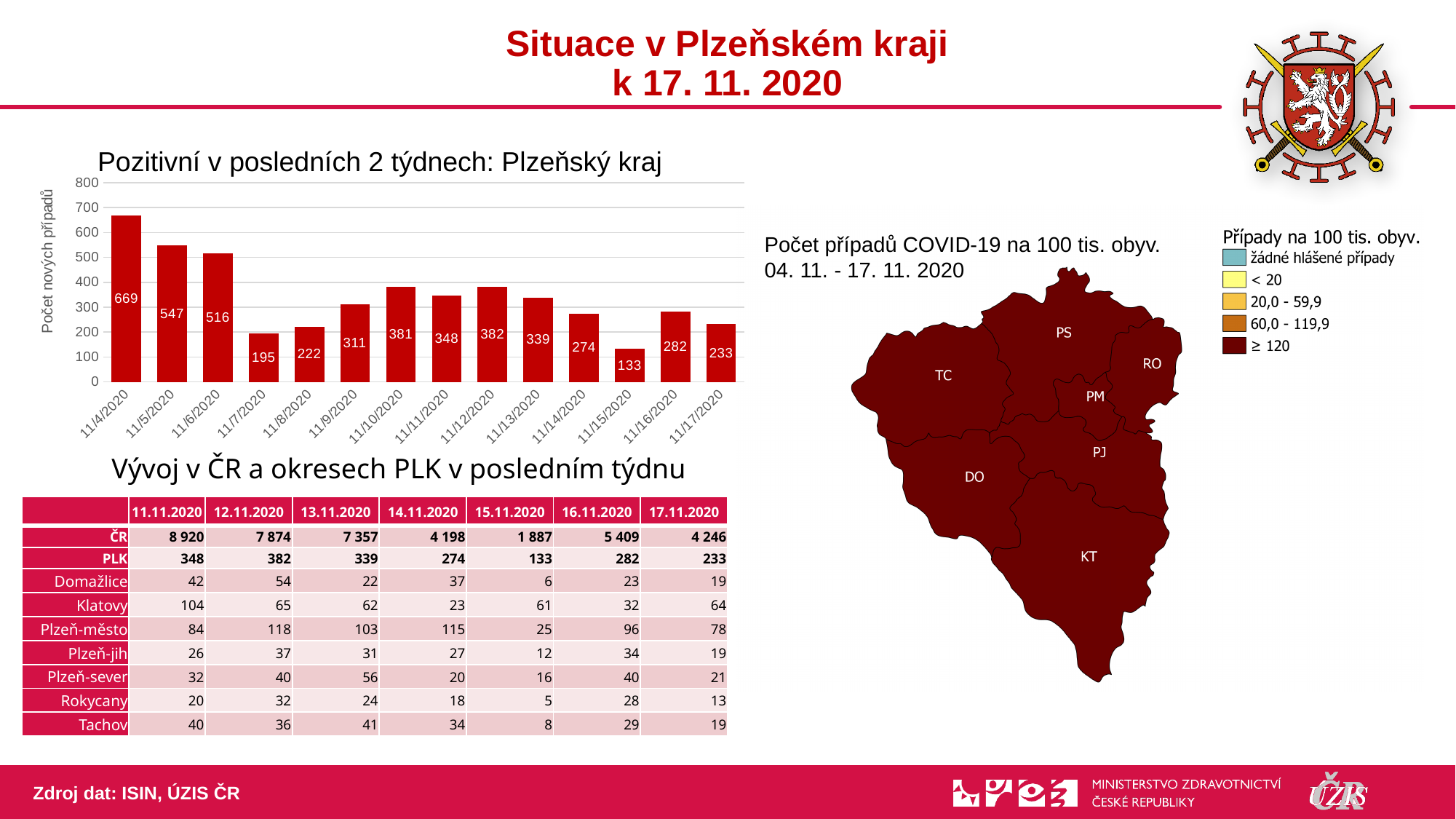
What is the y-axis title of the chart 'Pozitivní v posledních 2 týdnech: Plzeňský kraj'? Počet nových případů How many dates are shown on the x axis of the chart 'Pozitivní v posledních 2 týdnech: Plzeňský kraj'? 14 In the chart 'Pozitivní v posledních 2 týdnech: Plzeňský kraj', which date has the lowest value? 11/15/2020 In the chart 'Pozitivní v posledních 2 týdnech: Plzeňský kraj', do the values overall rise or fall from 11/4/2020 to 11/17/2020? fall In the chart 'Pozitivní v posledních 2 týdnech: Plzeňský kraj', which is larger, the value for 11/9/2020 or 11/13/2020? 11/13/2020 In the chart 'Pozitivní v posledních 2 týdnech: Plzeňský kraj', what is the value for 11/17/2020? 233 In the chart 'Pozitivní v posledních 2 týdnech: Plzeňský kraj', what is the difference between the values for 11/4/2020 and 11/5/2020? 122 In the chart 'Pozitivní v posledních 2 týdnech: Plzeňský kraj', which date has the highest value? 11/4/2020 In the chart 'Pozitivní v posledních 2 týdnech: Plzeňský kraj', what is the value for 11/4/2020? 669 What type of chart is 'Pozitivní v posledních 2 týdnech: Plzeňský kraj'? bar chart In the chart 'Pozitivní v posledních 2 týdnech: Plzeňský kraj', is the value for 11/7/2020 greater or less than 200? less In the chart 'Pozitivní v posledních 2 týdnech: Plzeňský kraj', what is the value for 11/12/2020? 382